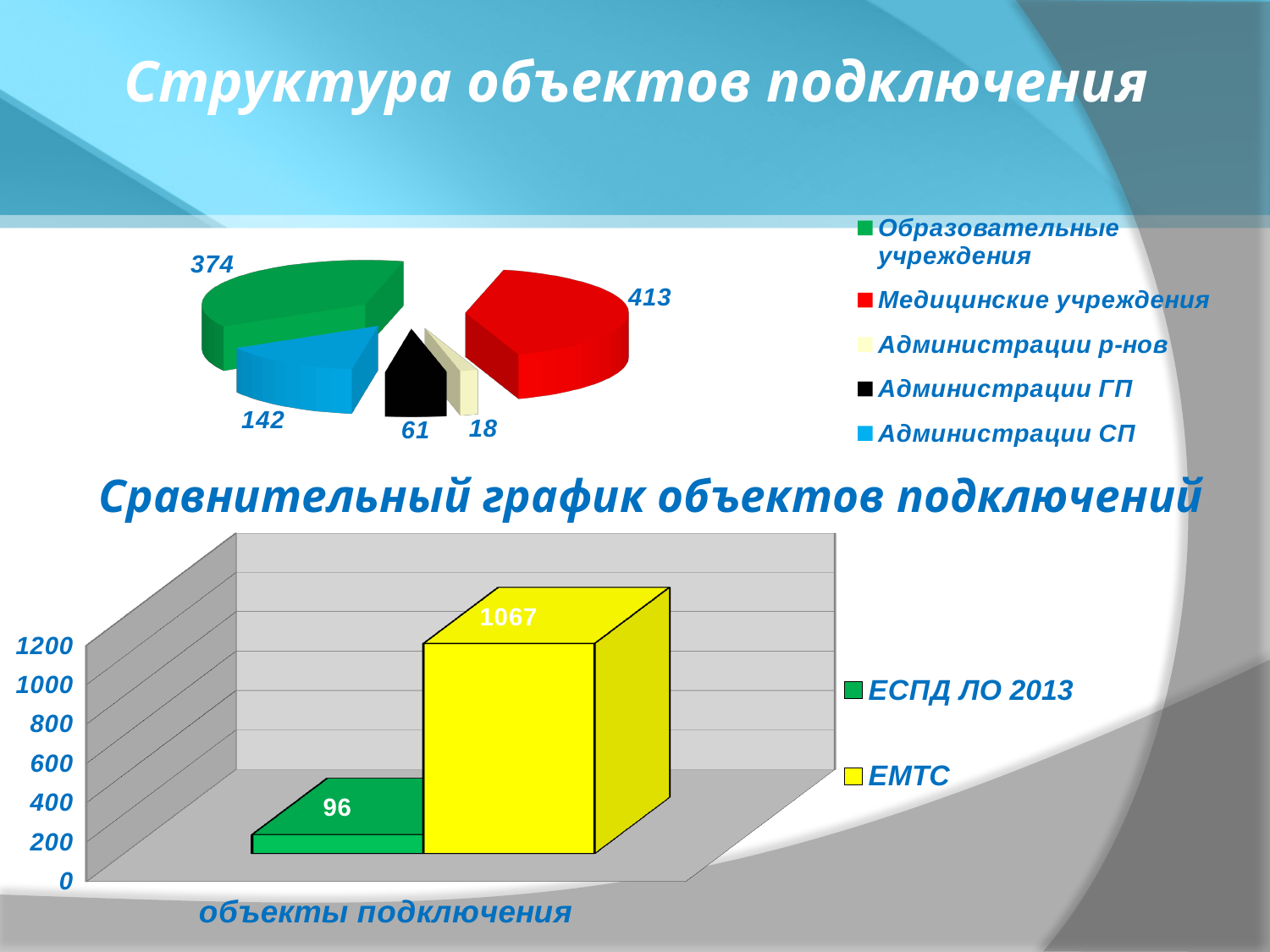
In the pie chart at the top of the slide, which category has the largest value? Медицинские учреждения In the pie chart at the top of the slide, what is the value for Медицинские учреждения? 413 In the pie chart at the top of the slide, what is the difference between the values for Медицинские учреждения and Образовательные учреждения? 39 In the chart titled 'Сравнительный график объектов подключений', what is the value for ЕСПД ЛО 2013? 96 In the pie chart at the top of the slide, what is the value for Администрации СП? 142 In the chart titled 'Сравнительный график объектов подключений', what is the value for ЕМТС? 1067 In the pie chart at the top of the slide, which category has the smallest value? Администрации р-нов What kind of chart is the one titled 'Сравнительный график объектов подключений'? Bar chart In the pie chart at the top of the slide, which colour represents Администрации ГП? Black In the chart titled 'Сравнительный график объектов подключений', what is the difference between the values for ЕМТС and ЕСПД ЛО 2013? 971 In the pie chart at the top of the slide, what is the value for Образовательные учреждения? 374 In the pie chart at the top of the slide, how many categories does the legend list? 5